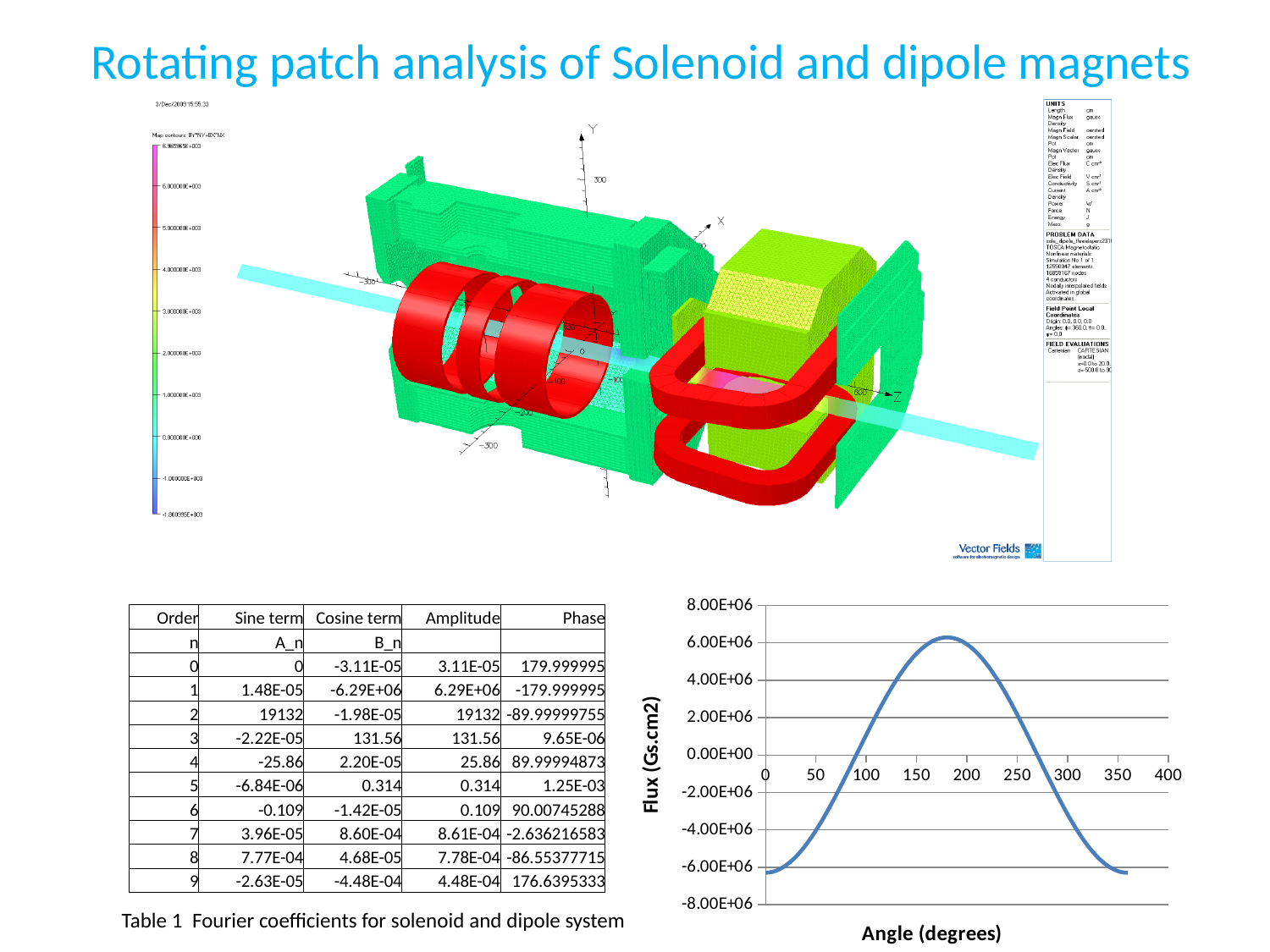
What is the label of the x axis of the Flux chart? Angle (degrees) In the Flux chart, is the flux at an angle of 150 degrees greater or less than 4.00E+06? greater What kind of chart is shown at the bottom right of the slide? line chart In the Flux chart, does the flux rise or fall as the angle increases from 0 to 180 degrees? rise In the Flux chart, is the flux at an angle of 0 degrees greater or less than -4.00E+06? less In the Flux chart, does the flux rise or fall as the angle increases from 180 to 360 degrees? fall What is the label of the y axis of the Flux chart? Flux (Gs.cm2) In the Flux chart, is the flux larger at 180 degrees or at 360 degrees? 180 degrees In the Flux chart, is the flux at an angle of 100 degrees greater or less than 0.00E+00? greater In the Flux chart, at which angle on the x axis does the flux reach its highest value? 180